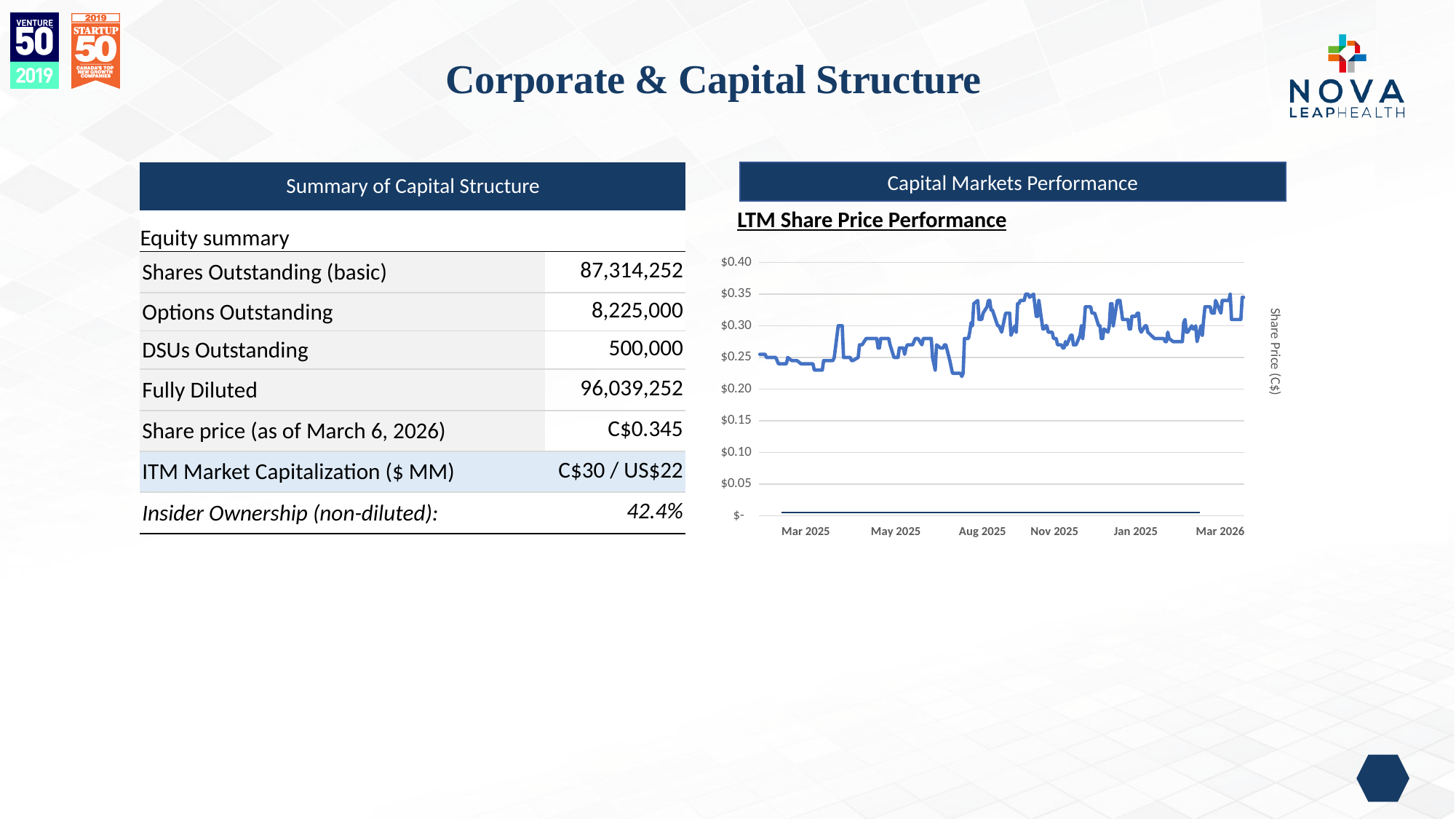
In the LTM Share Price Performance chart, does the share price overall rise or fall from Mar 2025 to Mar 2026? rise What kind of chart is the LTM Share Price Performance chart? line chart What is the highest tick value shown on the y axis of the LTM Share Price Performance chart? $0.40 In the LTM Share Price Performance chart, is the share price at Nov 2025 greater or less than $0.20? greater How many date labels are shown on the x axis of the LTM Share Price Performance chart? 6 How many lines (series) are plotted in the LTM Share Price Performance chart? 1 In the LTM Share Price Performance chart, is the share price at Mar 2026 greater or less than $0.30? greater What is the label of the vertical axis in the LTM Share Price Performance chart? Share Price (C$) In the LTM Share Price Performance chart, is the highest share price reached greater or less than $0.40? less